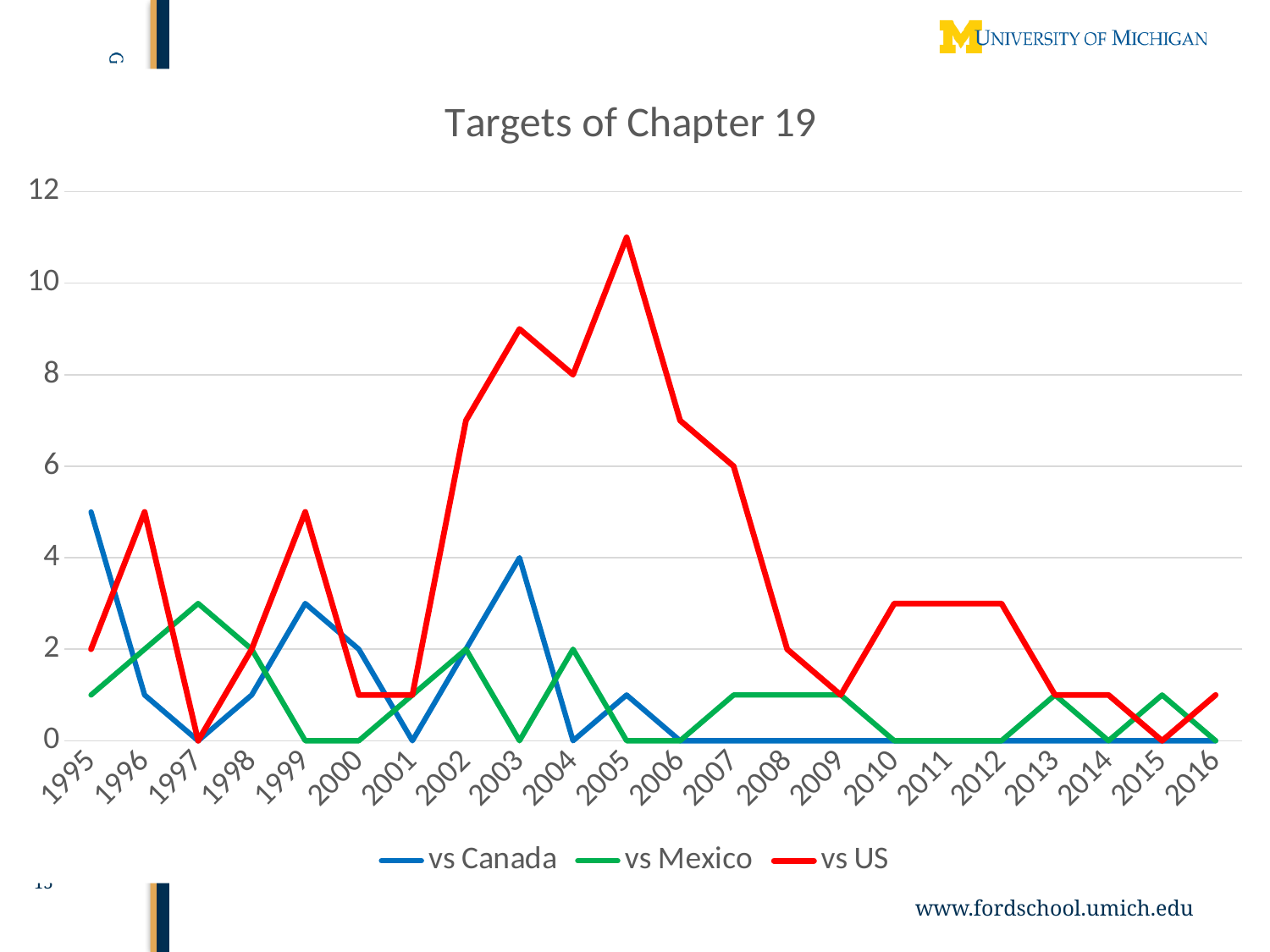
Does the vs US series rise or fall from 2005 to 2008? fall How many series does the legend list? 3 In which year does the vs US series reach its highest value? 2005 Which series is larger in 2003, vs US or vs Canada? vs US What is the vs Mexico value for 2004? 2 How many years are shown on the x axis? 22 What is the vs Canada value for 2003? 4 What is the difference between the vs US values for 2004 and 2007? 2 What is the title of the chart? Targets of Chapter 19 What type of chart is shown on the slide? line chart What is the vs US value for 2004? 8 Is the vs US value for 2005 greater or less than 10? greater